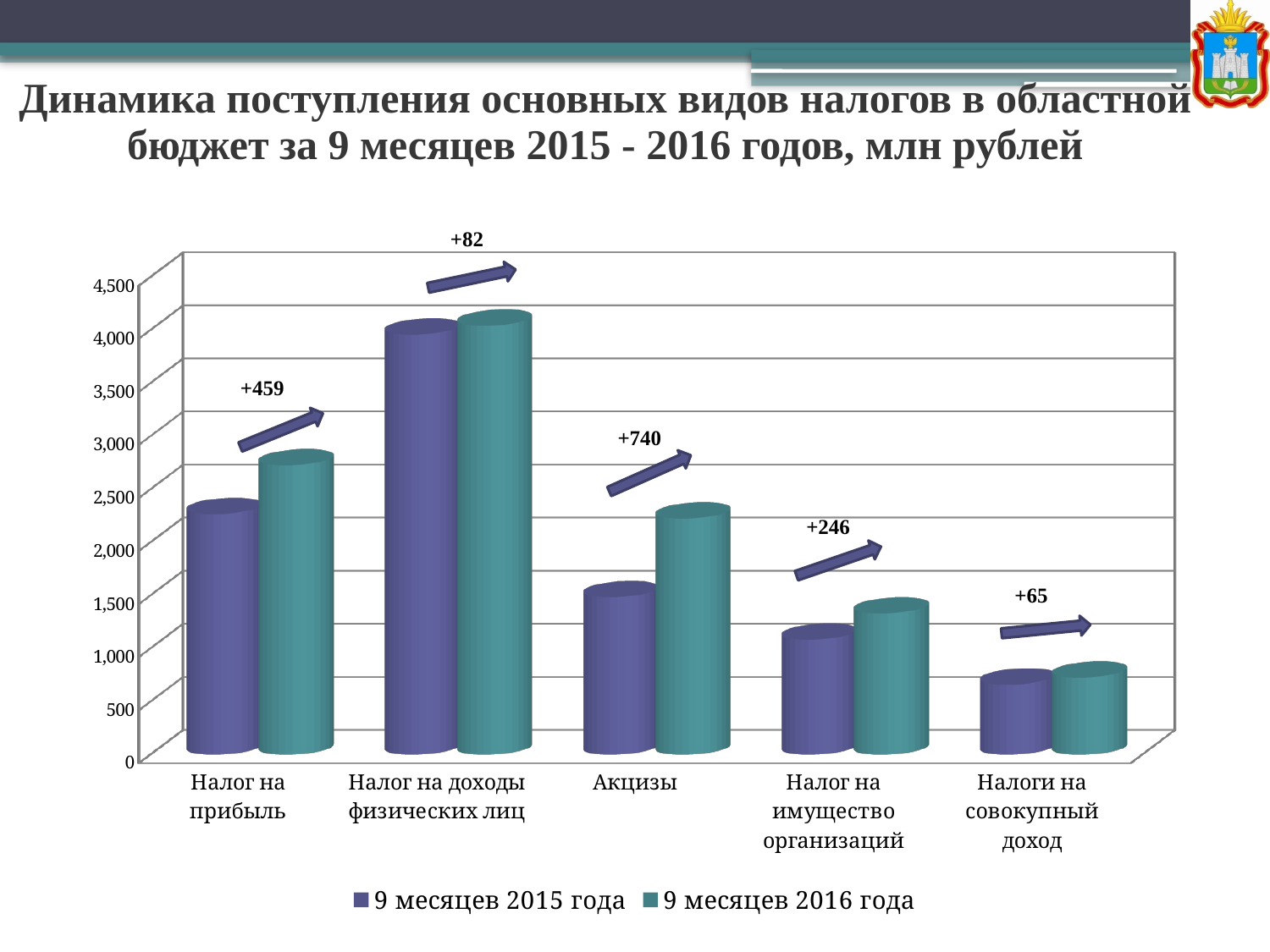
What are the two series named in the legend? 9 месяцев 2015 года and 9 месяцев 2016 года How many series does the legend list? 2 Is the value for Налог на прибыль for 9 месяцев 2015 года greater or less than 2,000? greater According to the annotation, by how much did Акцизы increase from 9 months of 2015 to 9 months of 2016? +740 According to the annotation, what is the increase for Налог на имущество организаций? +246 Which tax category has the lowest values in both years? Налоги на совокупный доход For 9 месяцев 2016 года, which is larger: Акцизы or Налог на имущество организаций? Акцизы According to the annotation, by how much did Налог на прибыль increase between the two periods? +459 Which tax category has the highest values in both years? Налог на доходы физических лиц Is the value for Налоги на совокупный доход for 9 месяцев 2016 года greater or less than 1,000? less How many tax categories are shown on the x axis? 5 What kind of chart is shown on the slide? bar chart